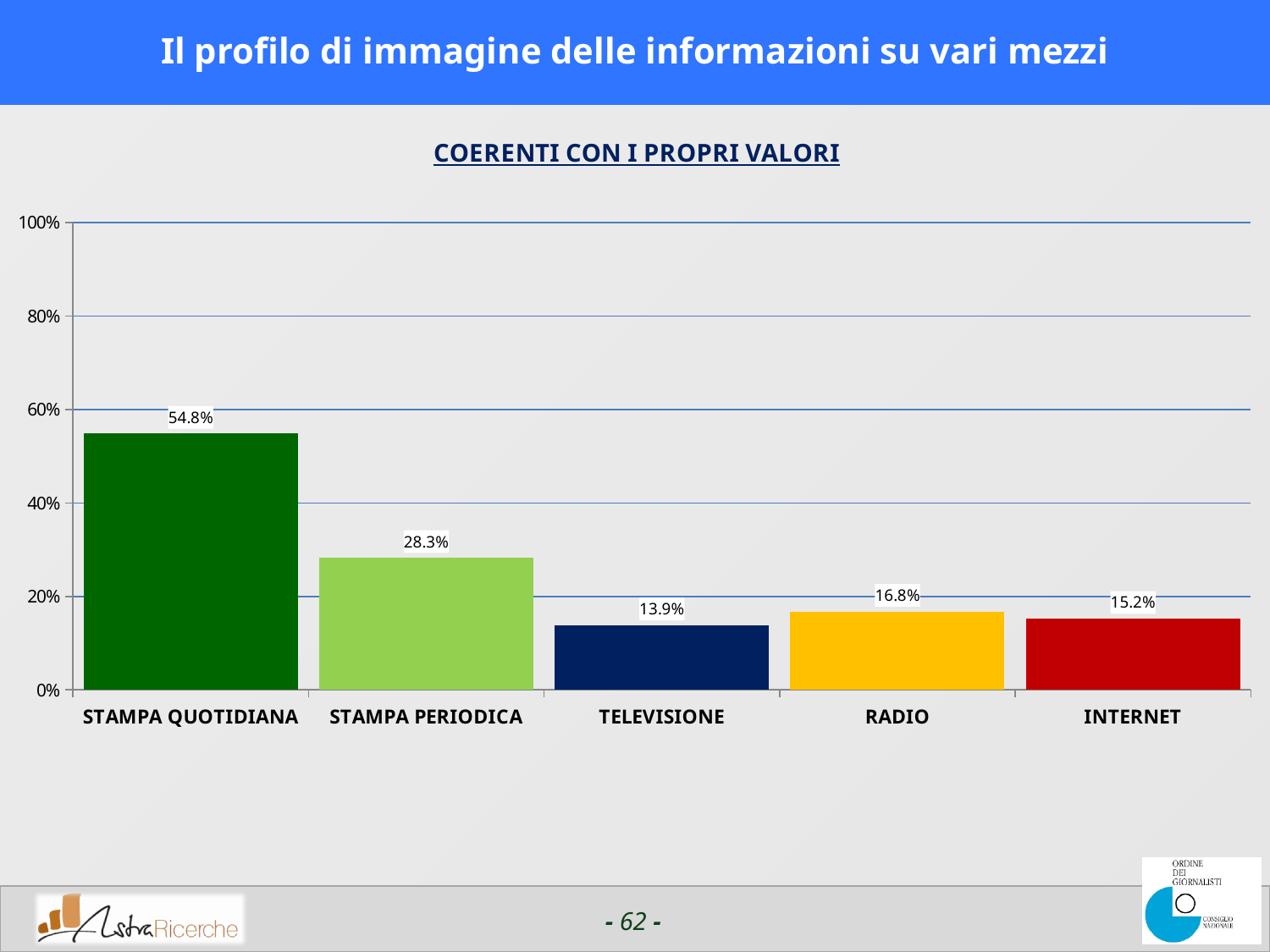
What is the difference between the values for RADIO and TELEVISIONE? 2.9% What is the value for RADIO? 16.8% Which category has the lowest value? TELEVISIONE What is the title of the chart? COERENTI CON I PROPRI VALORI Is the value for STAMPA PERIODICA greater or less than 40%? less Which is larger, the value for RADIO or the value for INTERNET? RADIO What kind of chart is shown on the slide? bar chart What is the value for STAMPA QUOTIDIANA? 54.8% What is the value for INTERNET? 15.2% Which category has the highest value? STAMPA QUOTIDIANA How many categories are shown on the x axis? 5 What is the difference between the values for STAMPA QUOTIDIANA and STAMPA PERIODICA? 26.5%